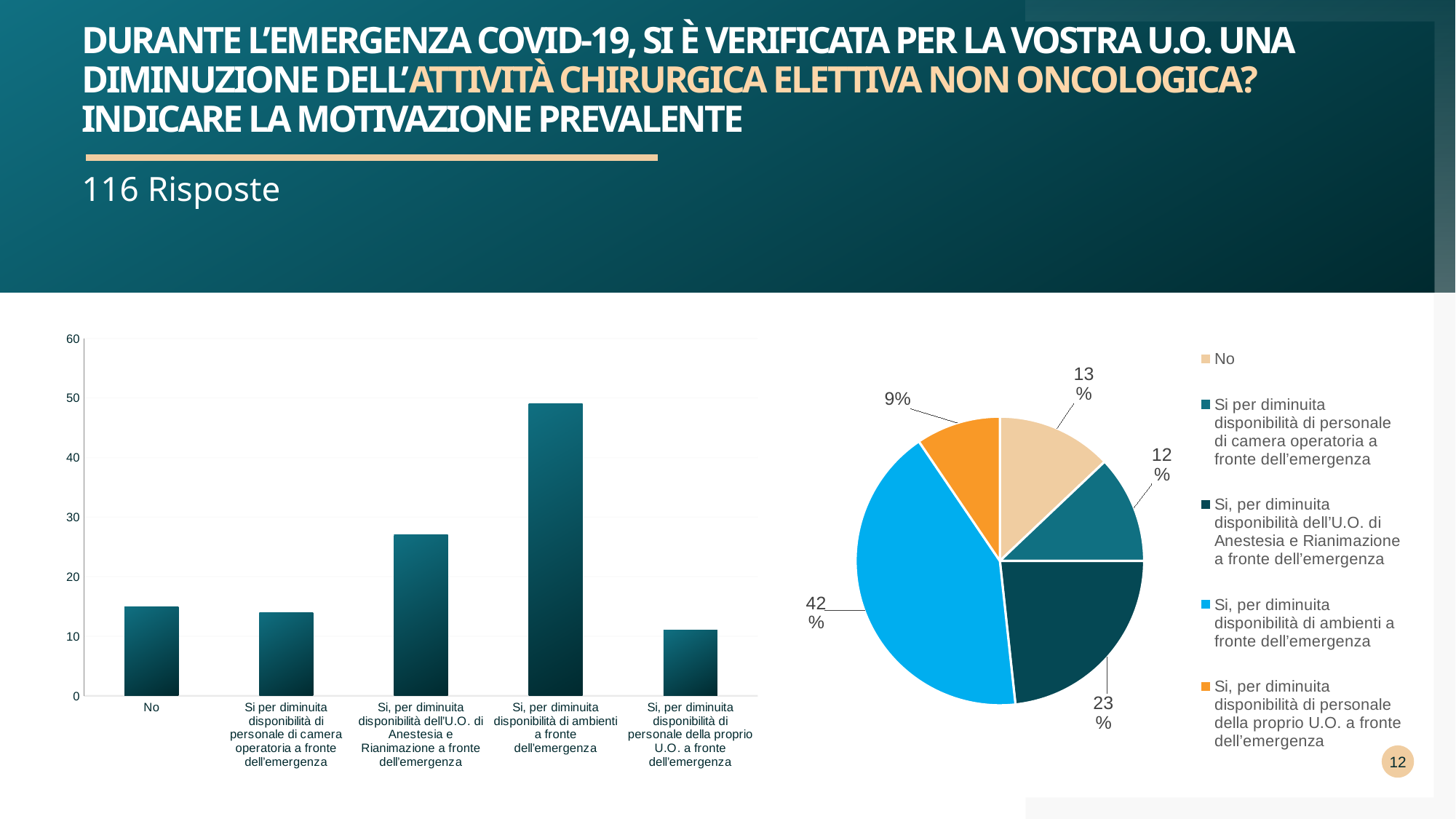
What kind of chart is the chart on the right of the slide? pie chart In the pie chart on the right, which slice is the smallest? Si, per diminuita disponibilità di personale della proprio U.O. a fronte dell'emergenza In the pie chart on the right, what share is labelled for 'No'? 13% In the bar chart on the left, is the value for 'Si, per diminuita disponibilità dell'U.O. di Anestesia e Rianimazione a fronte dell'emergenza' greater or less than 20? greater In the bar chart on the left, is the value for 'No' greater or less than 20? less In the pie chart on the right, what share is labelled for 'Si, per diminuita disponibilità di ambienti a fronte dell'emergenza'? 42% In the bar chart on the left, how many categories are shown? 5 In the pie chart on the right, what is the difference between the 42% slice and the 23% slice? 19% In the bar chart on the left, is the value for 'Si, per diminuita disponibilità di ambienti a fronte dell'emergenza' greater or less than 40? greater How many entries does the legend of the pie chart on the right list? 5 In the bar chart on the left, which category has the highest bar? Si, per diminuita disponibilità di ambienti a fronte dell'emergenza What kind of chart is the chart on the left of the slide? bar chart